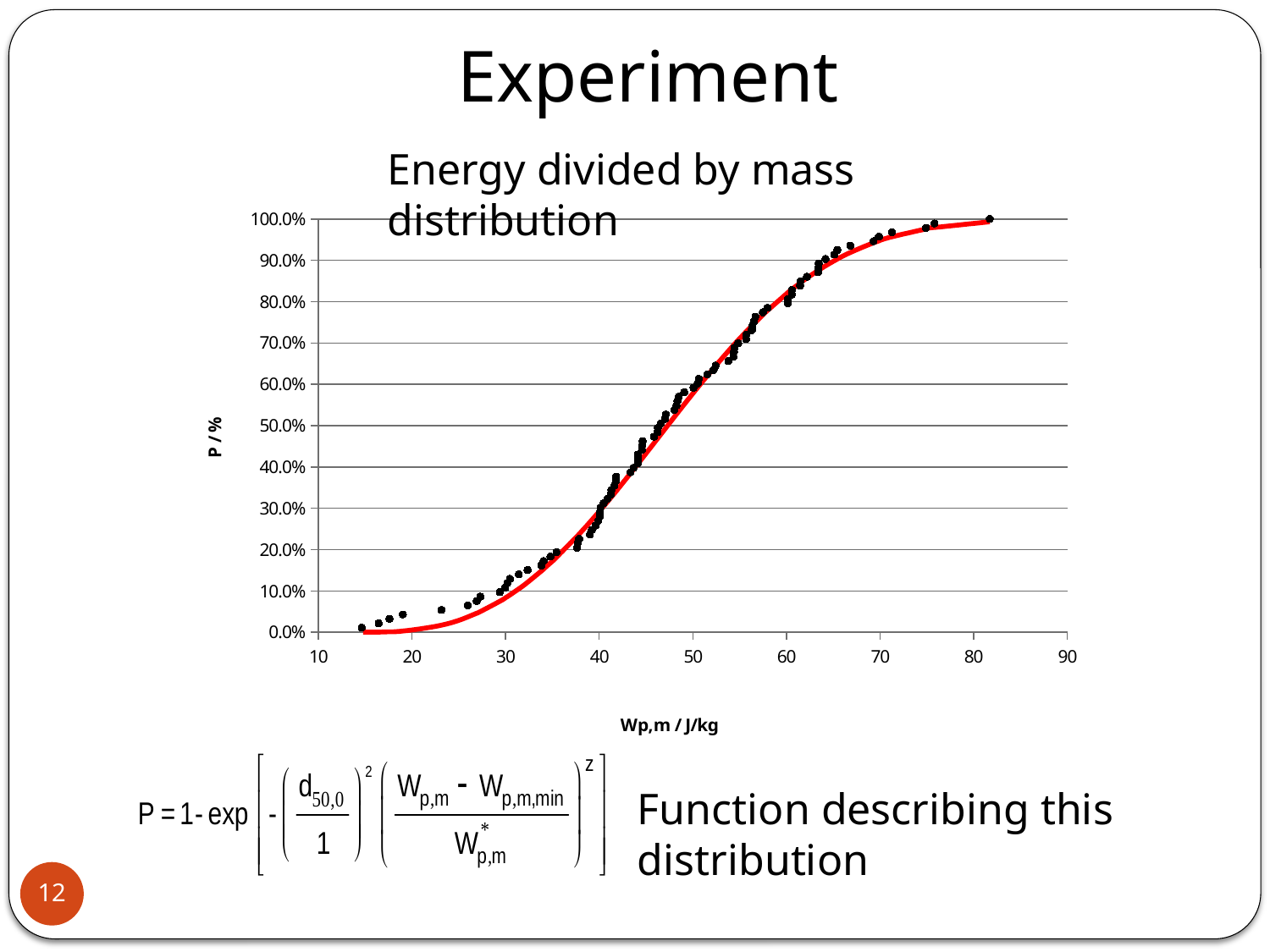
Is the value of P at Wp,m = 55 J/kg greater or less than 60.0%? greater Is the value of P at Wp,m = 30 J/kg greater or less than 20.0%? less Is the value of P at Wp,m = 40 J/kg greater or less than 50.0%? less What is the label of the x axis? Wp,m / J/kg What kind of chart is shown on the slide? scatter chart What is the highest tick value shown on the y axis? 100.0% What is the title of the chart? Energy divided by mass distribution Do the plotted values rise or fall as Wp,m increases along the x axis? rise